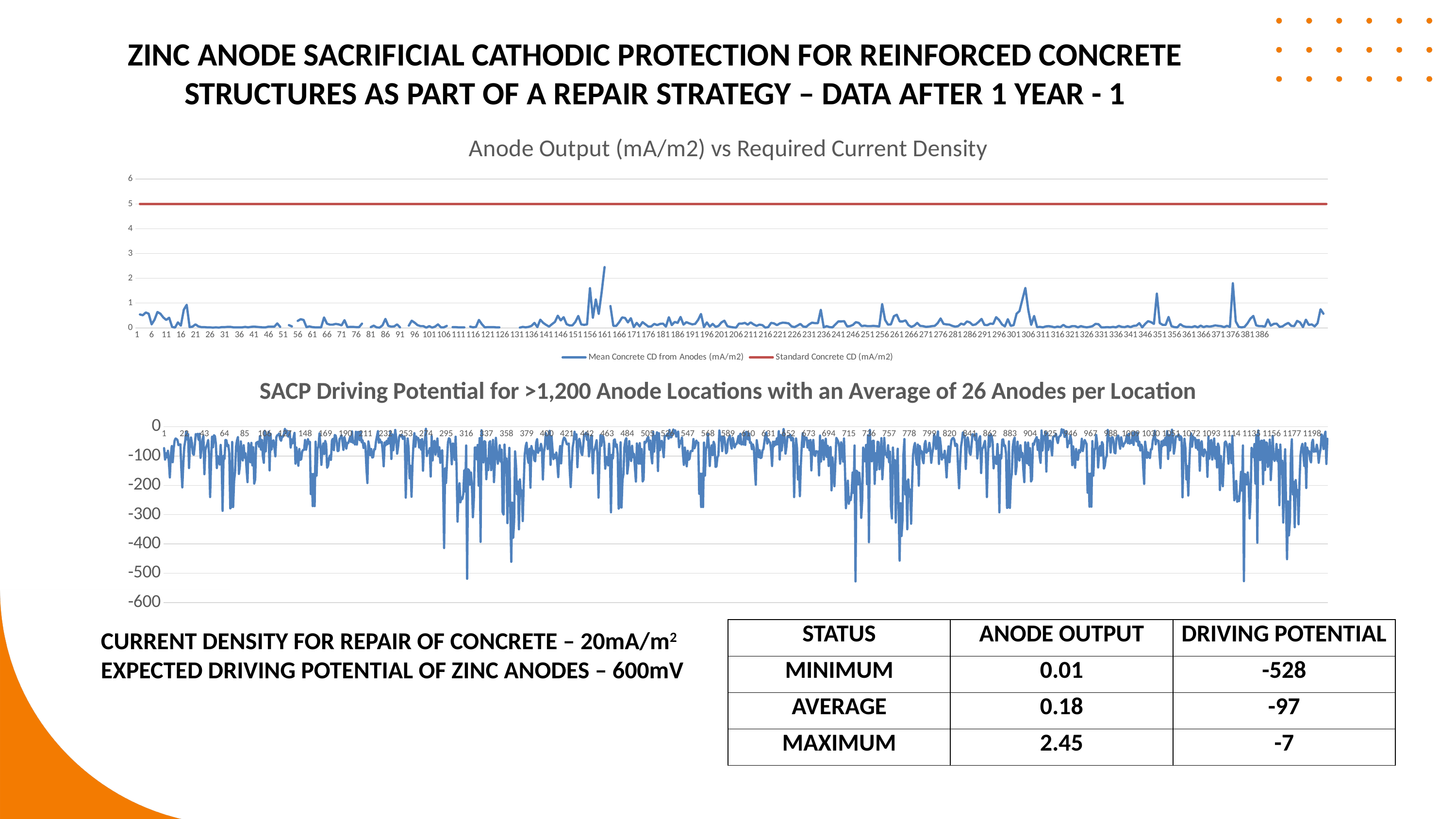
What type of chart is the top chart titled "Anode Output (mA/m2) vs Required Current Density"? Line chart What type of chart is the bottom chart titled "SACP Driving Potential for >1,200 Anode Locations with an Average of 26 Anodes per Location"? Line chart On the bottom chart "SACP Driving Potential for >1,200 Anode Locations", is the lowest point of the line greater or less than -500? less How many series does the legend of the top chart "Anode Output (mA/m2) vs Required Current Density" list? 2 On the top chart "Anode Output (mA/m2) vs Required Current Density", is the Standard Concrete CD line greater or less than 4? greater On the top chart "Anode Output (mA/m2) vs Required Current Density", which series has the higher values throughout: Mean Concrete CD from Anodes or Standard Concrete CD? Standard Concrete CD (mA/m2) What is the title of the bottom chart on the slide? SACP Driving Potential for >1,200 Anode Locations with an Average of 26 Anodes per Location On the top chart "Anode Output (mA/m2) vs Required Current Density", is the highest peak of the Mean Concrete CD from Anodes line greater or less than 3? less On the top chart "Anode Output (mA/m2) vs Required Current Density", at what constant value does the Standard Concrete CD (mA/m2) line sit? 5 What are the two legend entries on the top chart "Anode Output (mA/m2) vs Required Current Density"? Mean Concrete CD from Anodes (mA/m2) and Standard Concrete CD (mA/m2)